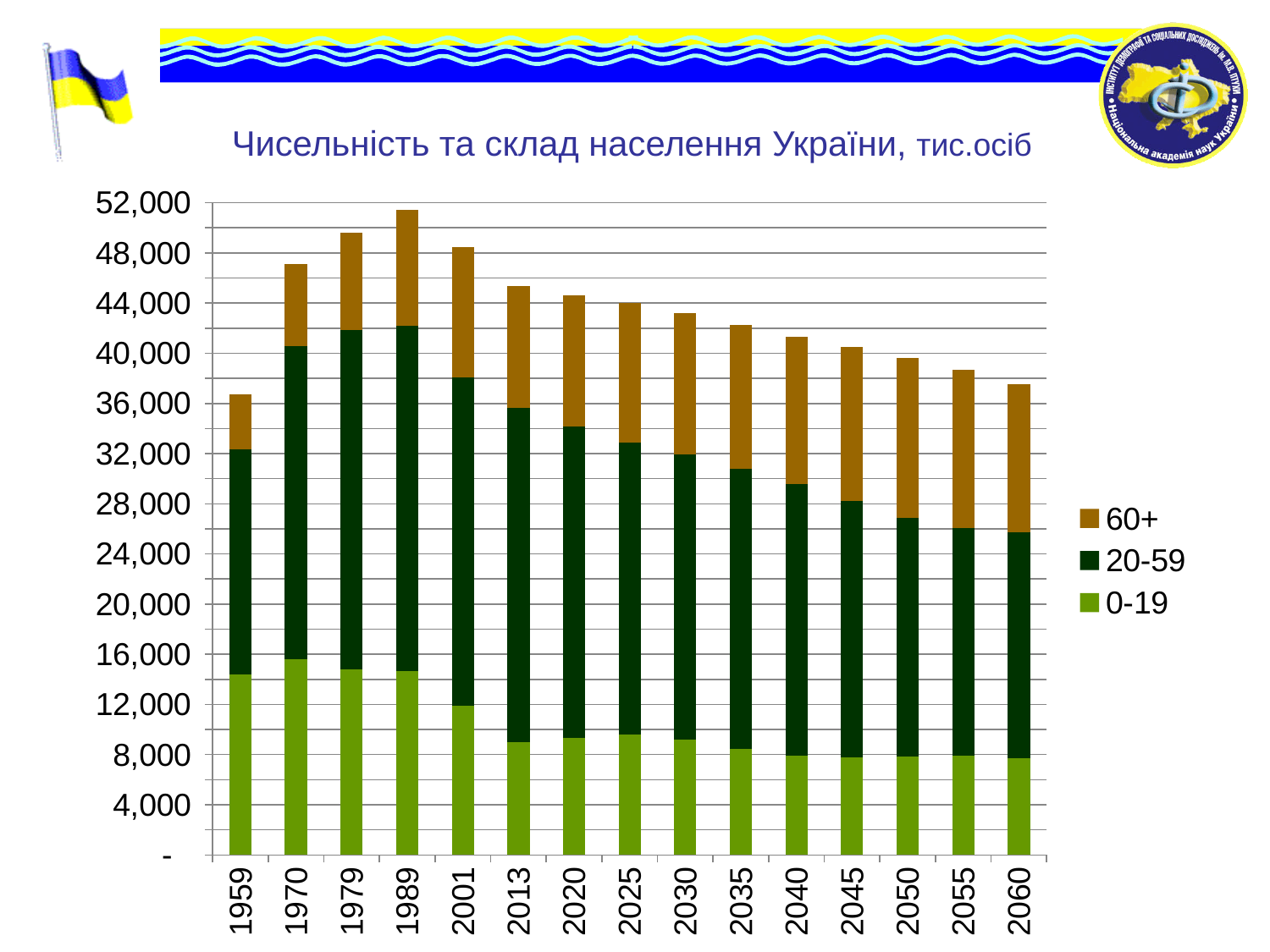
Is the 0-19 segment for 1970 greater or less than 12,000? greater Is the total bar for 1959 greater or less than 40,000? less How many series does the legend list? 3 What unit is given in the chart title? тис.осіб Is the total bar for 2060 greater or less than 40,000? less How many years are shown along the x axis? 15 Which series is shown in brown at the top of each bar? 60+ Which total bar is taller, 1989 or 1959? 1989 Do the total bars rise or fall from 1989 to 2060? fall What kind of chart is shown on the slide? Stacked bar chart Which year has the highest total population bar? 1989